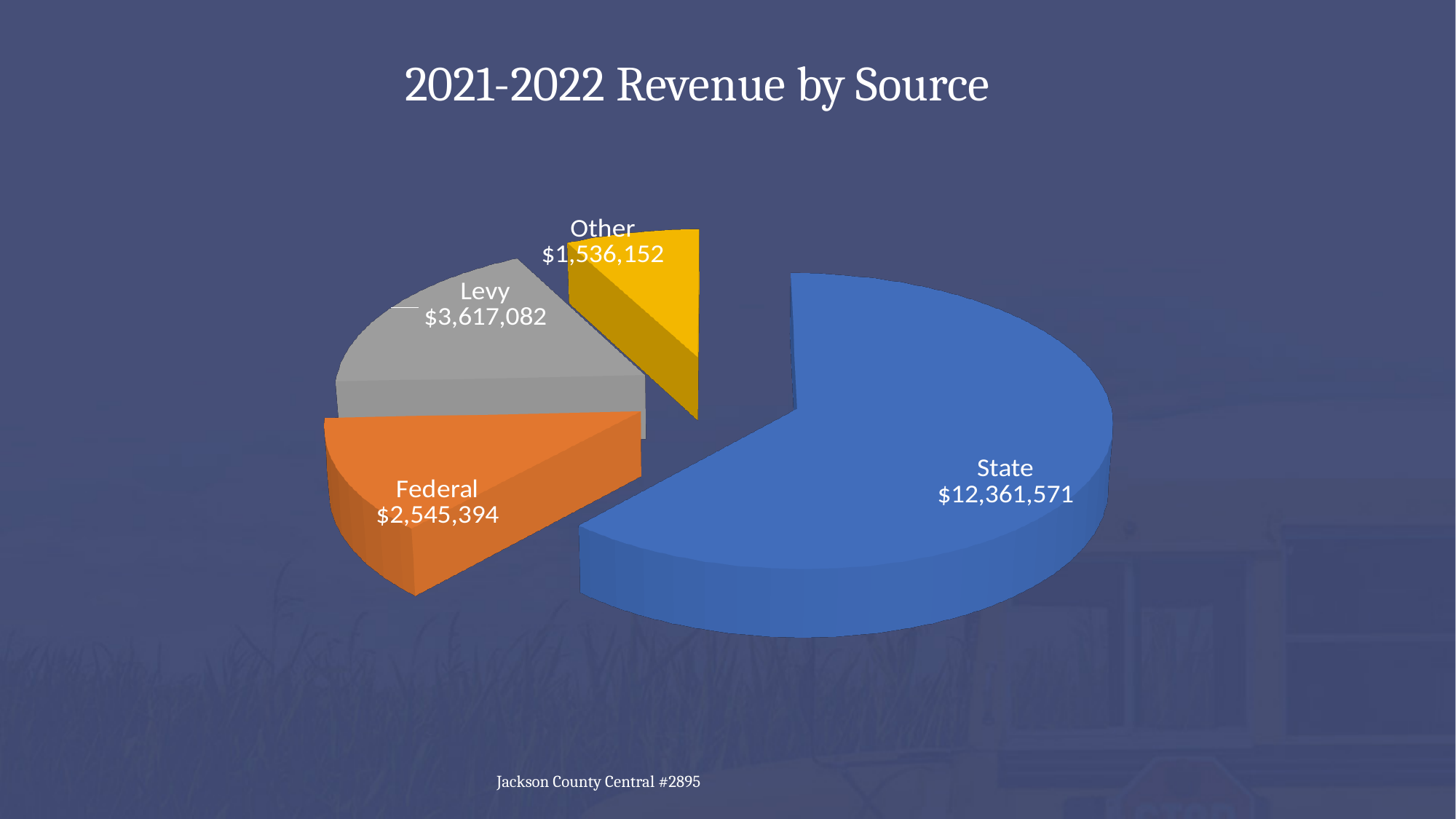
What is the revenue value for Levy? $3,617,082 What is the title of the chart? 2021-2022 Revenue by Source What is the revenue value for State? $12,361,571 Which revenue source is the largest? State What is the total revenue across all four sources? $20,060,199 Which is larger, Levy revenue or Federal revenue? Levy Which revenue source is the smallest? Other What type of chart is shown on the slide? Pie chart How many revenue sources (slices) are shown in the pie chart? 4 What is the revenue value for Federal? $2,545,394 What is the revenue value for Other? $1,536,152 What is the difference between State revenue and Levy revenue? $8,744,489